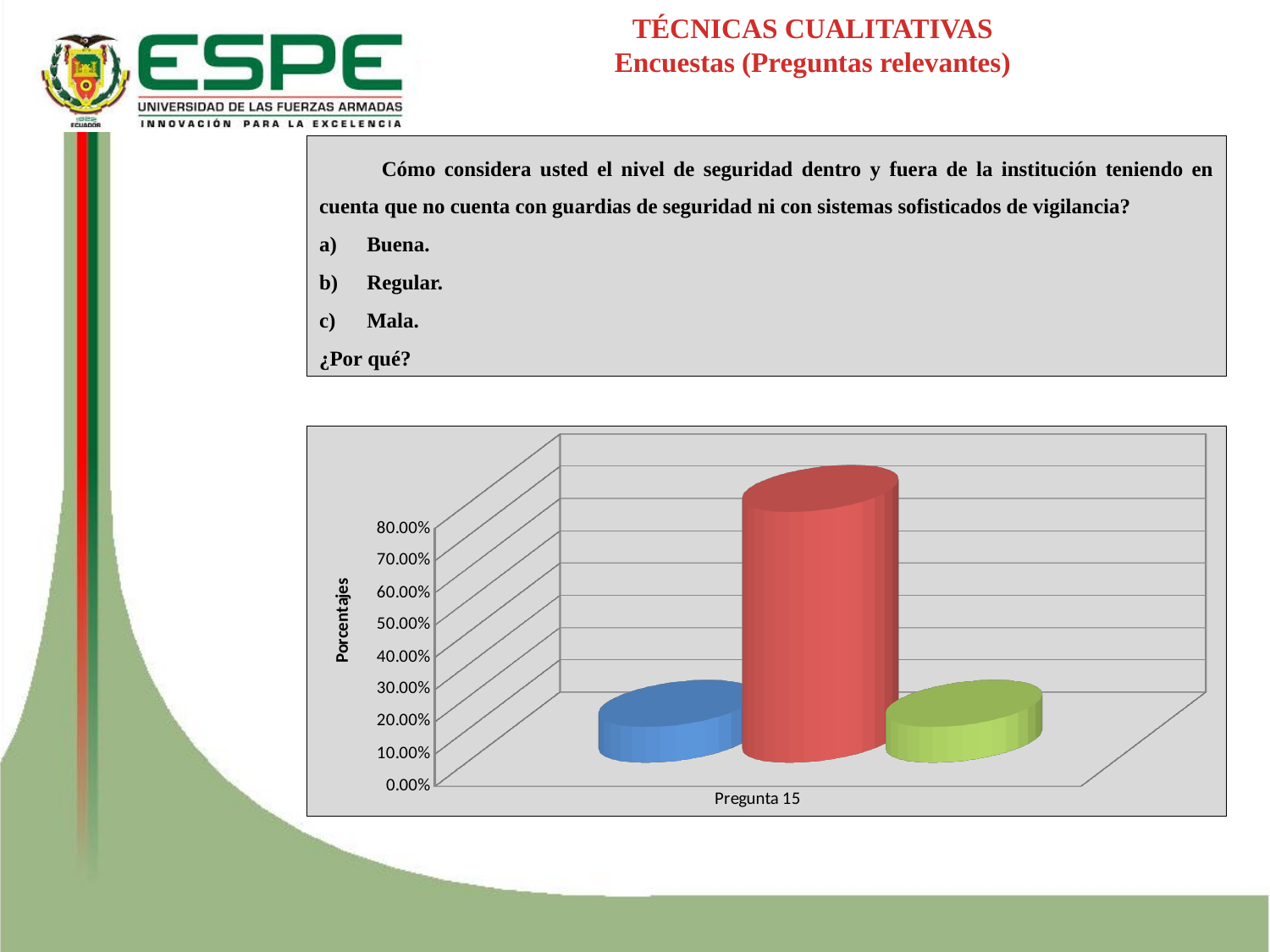
Which bar is the tallest in the chart? the red bar Is the value of the red bar greater or less than 50.00%? greater Is the value of the blue bar greater or less than 40.00%? less What category label appears on the horizontal axis of the chart? Pregunta 15 Which is larger, the value of the green bar or the value of the red bar? the red bar How many bars are plotted in the chart? 3 Which is larger, the value of the red bar or the value of the blue bar? the red bar What is the highest tick value shown on the vertical axis? 80.00% What is the title of the vertical axis of the chart? Porcentajes What kind of chart is shown on the slide? bar chart Is the value of the green bar greater or less than 40.00%? less